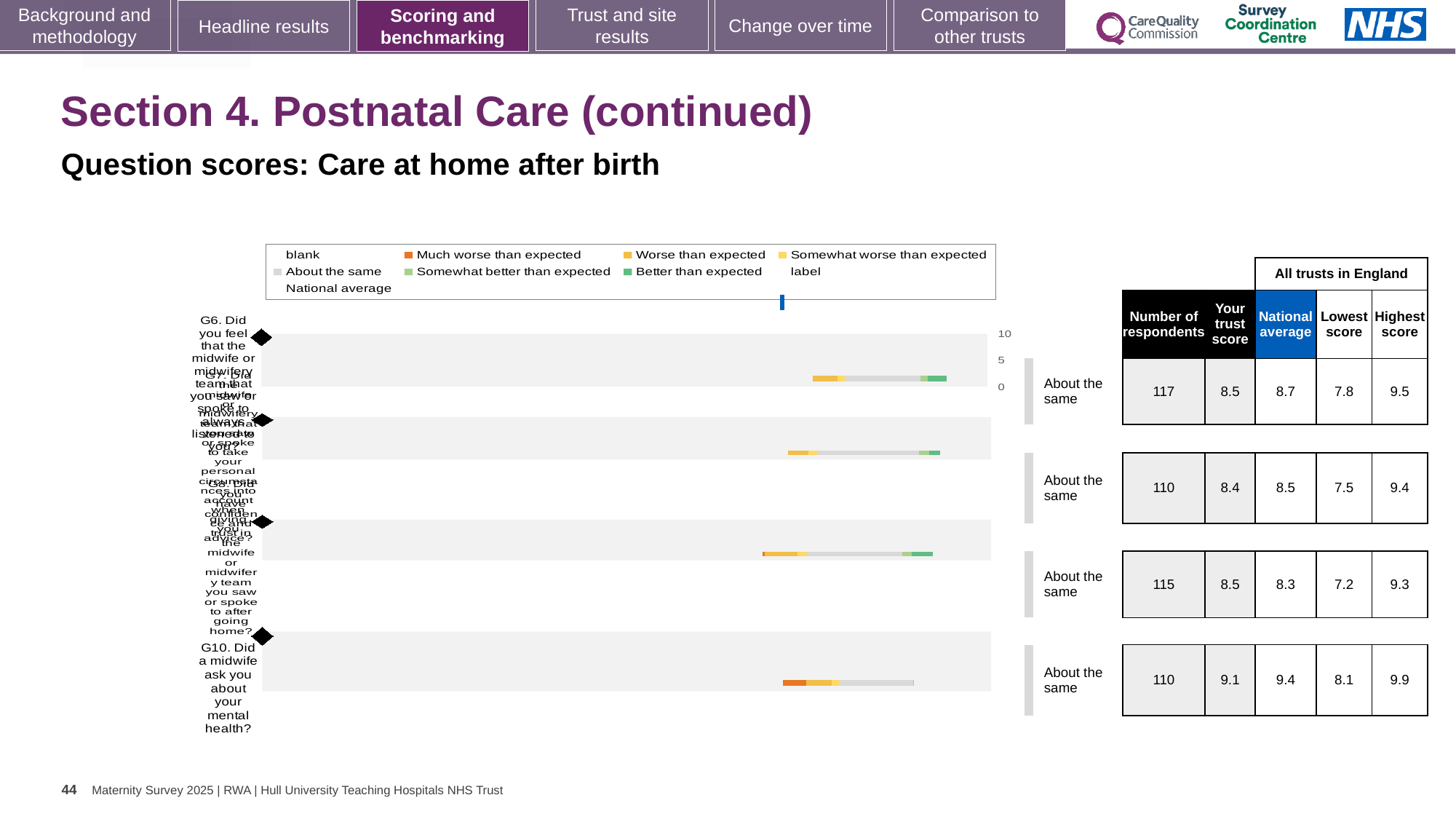
What is the national average for G10 (Did a midwife ask you about your mental health?) shown in the table beside the chart? 9.4 How many respondents are listed for G10 (Did a midwife ask you about your mental health?)? 110 Which legend entry is shown in dark orange? Much worse than expected What is the highest score across all trusts in England for G10 (Did a midwife ask you about your mental health?)? 9.9 What is the difference between the national average and the trust score for G10 (Did a midwife ask you about your mental health?)? 0.3 What is the trust score for G10 (Did a midwife ask you about your mental health?) shown in the table beside the chart? 9.1 What benchmark category is shown next to every question bar in the chart? About the same How many question bars are plotted in the chart? 4 What is the number of respondents for the first (top) question bar in the chart? 117 Which is larger for G10 (Did a midwife ask you about your mental health?): the trust score or the national average? national average What is the lowest score across all trusts in England for the third question bar in the chart? 7.2 What kind of chart is shown on the slide? bar chart